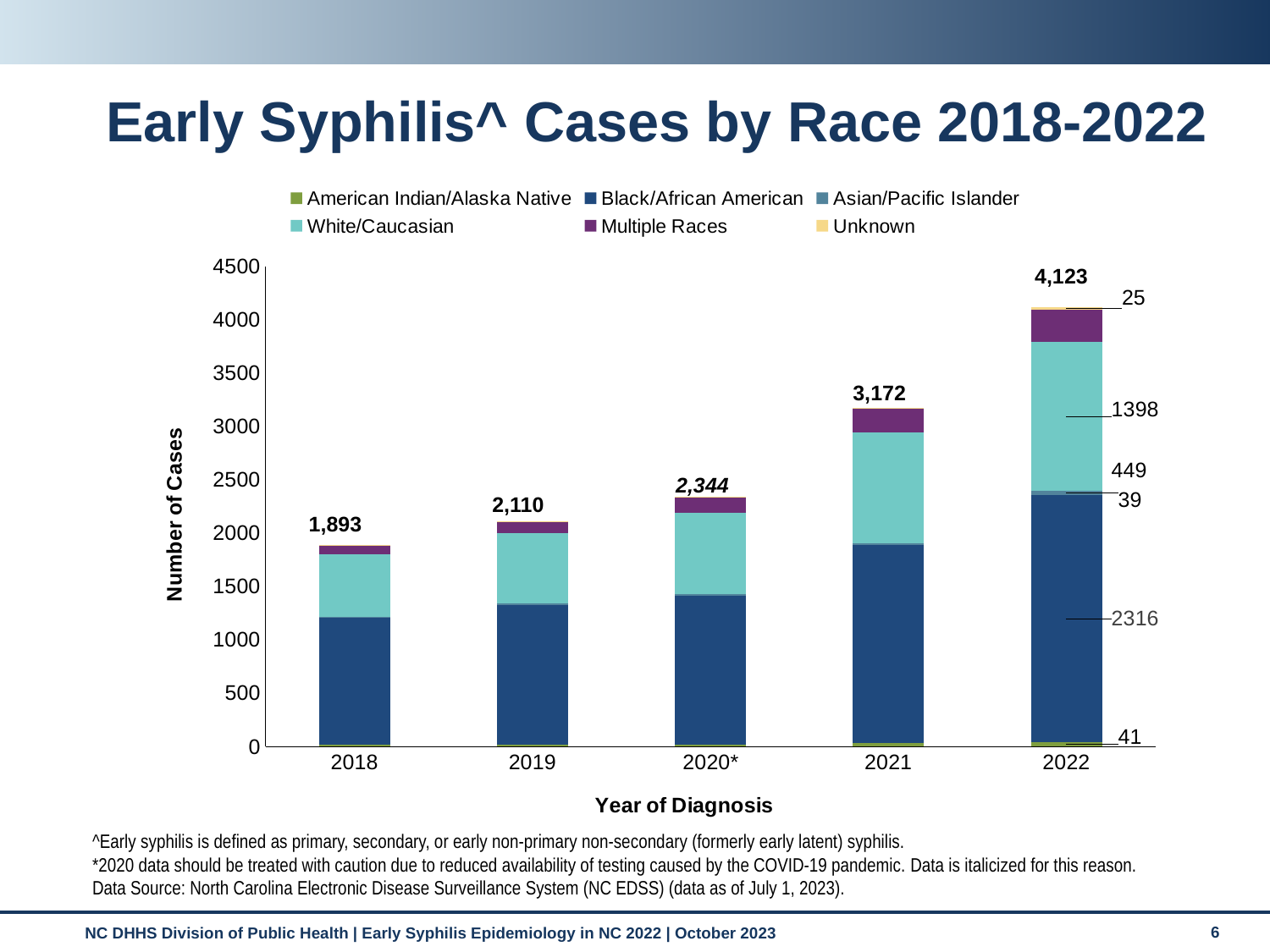
Which year has the lowest total number of early syphilis cases? 2018 Is the Black/African American segment for 2021 greater or less than 1500? greater What is the total number of cases labeled for 2020*? 2,344 What is the difference between the total cases in 2022 and 2021? 951 What is the difference between the total cases in 2019 and 2018? 217 What is the total number of early syphilis cases shown for 2022? 4,123 Which year has the highest total number of early syphilis cases? 2022 What is the total number of cases labeled for 2018? 1,893 Do total early syphilis cases rise or fall from 2018 to 2022? rise How many race categories does the legend list? 6 How many White/Caucasian cases are labeled in the 2022 bar? 1398 How many Black/African American cases are labeled in the 2022 bar? 2316